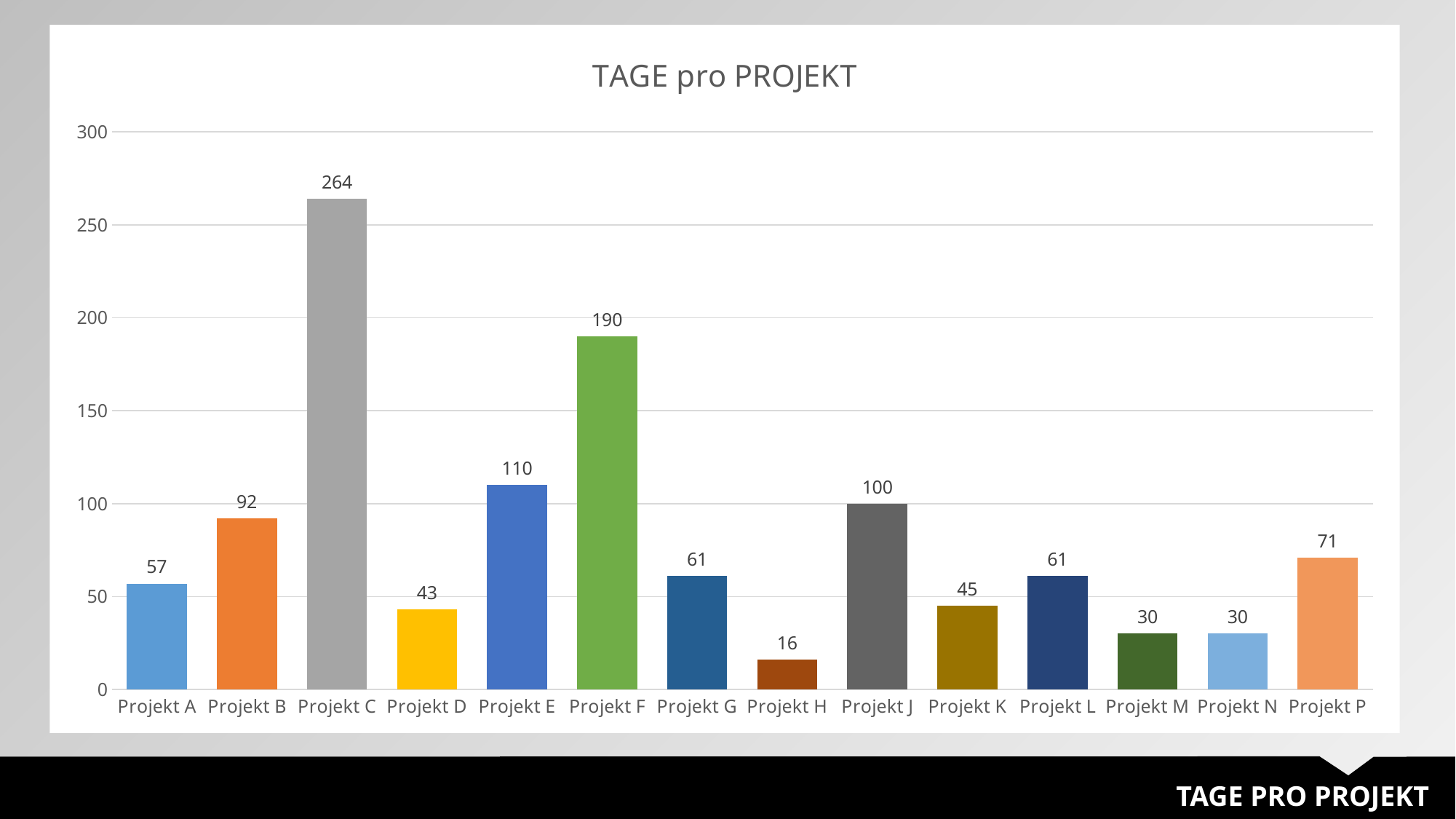
Which project has the lowest value? Projekt H What is the difference between the values for Projekt E and Projekt J? 10 What is the value for Projekt K? 45 How many projects are shown on the x axis? 14 What is the difference between the values for Projekt C and Projekt F? 74 What is the title of the chart? TAGE pro PROJEKT What is the value for Projekt C? 264 What is the value for Projekt H? 16 Which is larger, the value for Projekt B or the value for Projekt P? Projekt B What kind of chart is shown on the slide? bar chart Is the value for Projekt F greater or less than 150? greater Which project has the highest value? Projekt C